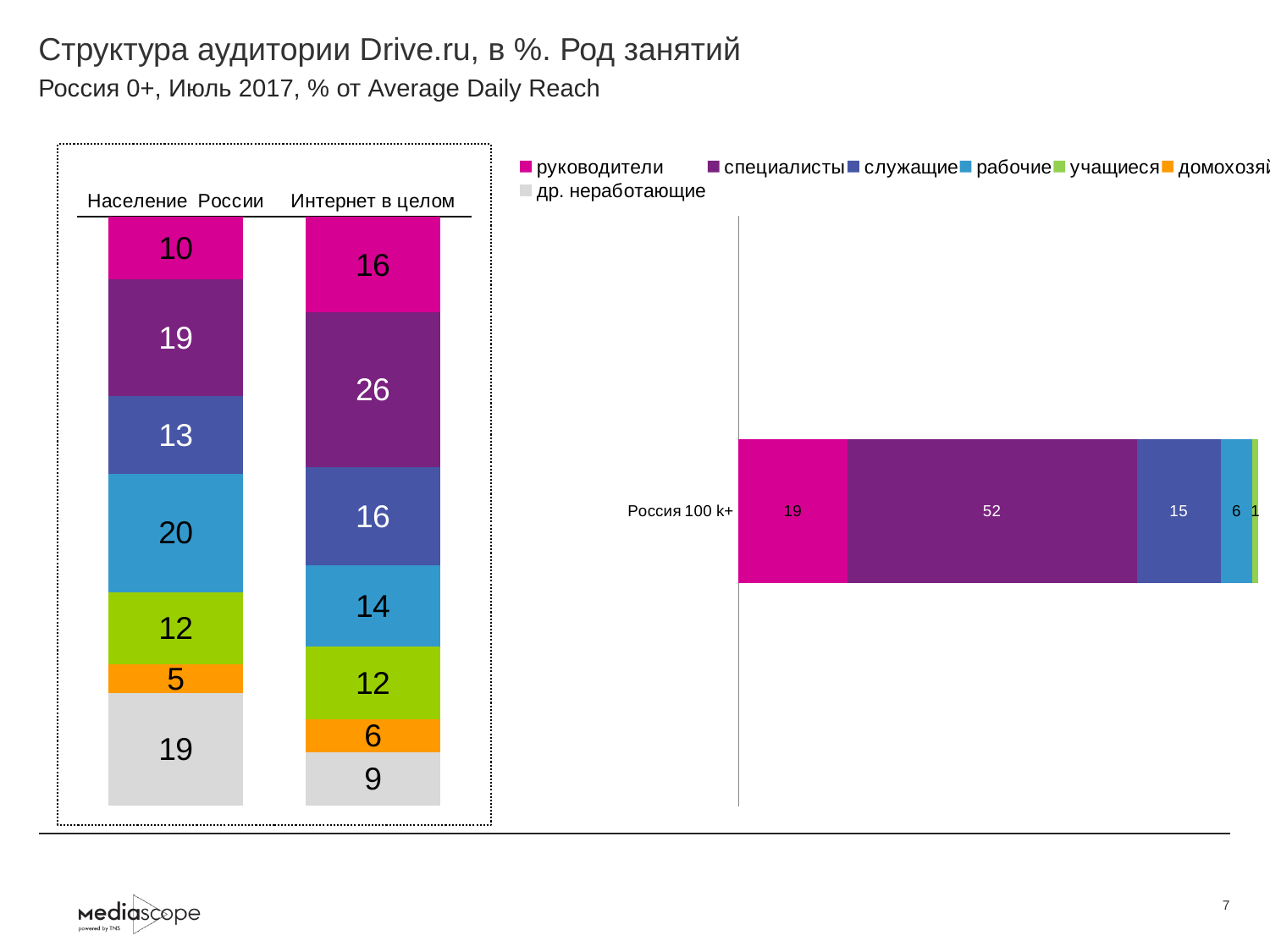
In the left chart, what is the value of the рабочие (blue) segment for Население России? 20 In the right chart, what is the difference between the специалисты and служащие values for Россия 100 k+? 37 In the right chart, what is the value of the специалисты (purple) segment for Россия 100 k+? 52 What type of chart is shown on the right side of the slide? Stacked bar chart In the left chart, what is the value of the специалисты (purple) segment for Интернет в целом? 26 In the left chart, what is the value of the домохозяйки (orange) segment for Население России? 5 In the left chart, what is the difference between the руководители values for Интернет в целом and Население России? 6 How many series does the legend list? 7 In the left chart, which segment is the largest in the Интернет в целом bar? специалисты In the right chart, what is the value of the руководители (pink) segment for Россия 100 k+? 19 In the left chart, which is larger: the др. неработающие value for Население России or for Интернет в целом? Население России In the left chart, which segment is the smallest in the Население России bar? домохозяйки